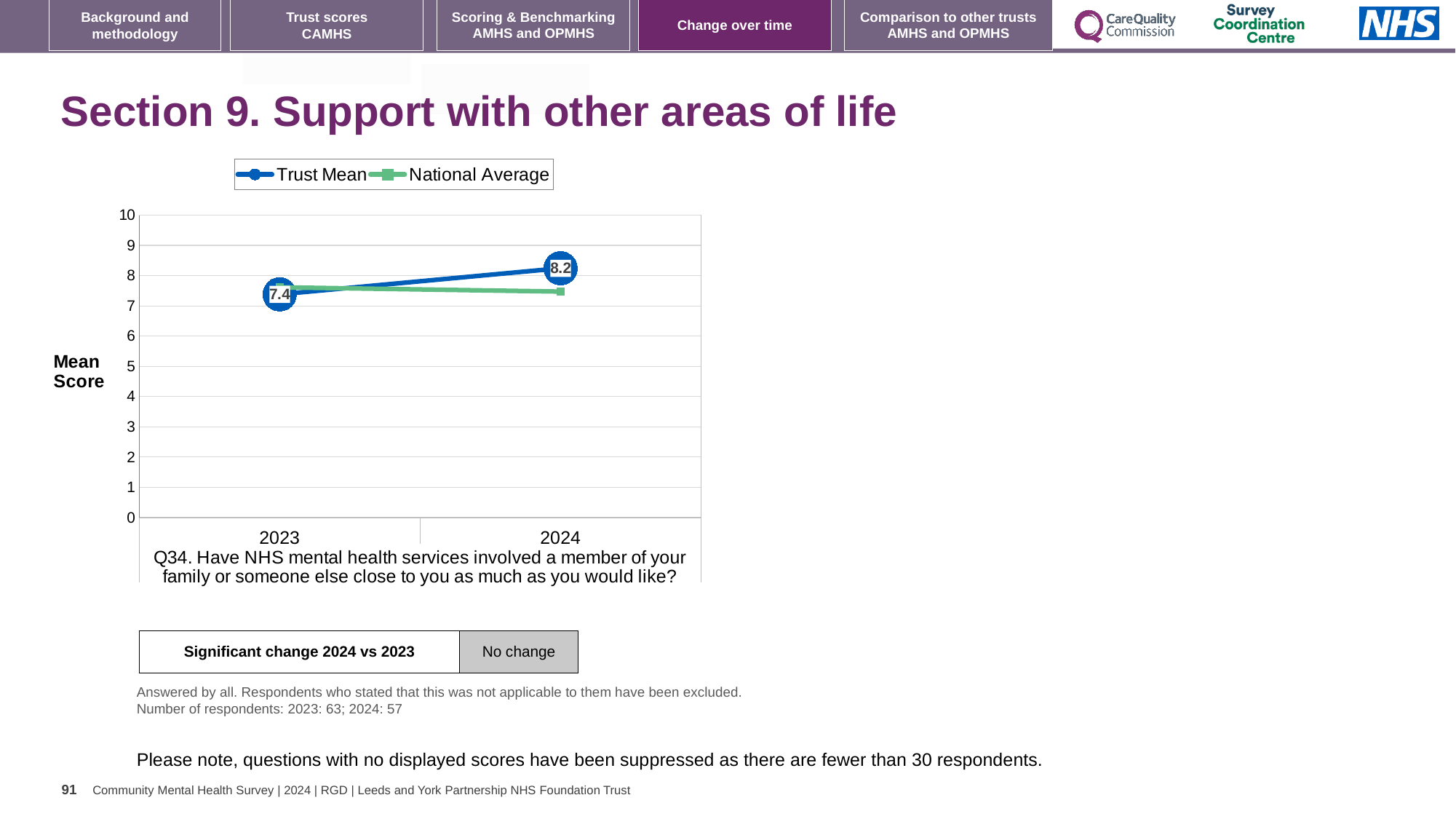
In 2024, which is higher, the Trust Mean or the National Average? Trust Mean What is the Trust Mean score for 2023? 7.4 What is the Trust Mean score for 2024? 8.2 How many years are shown on the x axis? 2 Is the National Average value for 2024 greater or less than 8? less In which year is the Trust Mean score higher, 2023 or 2024? 2024 What is the label of the y axis? Mean Score Does the Trust Mean score rise or fall from 2023 to 2024? rise What kind of chart is shown on the slide? line chart Is the National Average value for 2023 greater or less than 7? greater By how much did the Trust Mean score change from 2023 to 2024? 0.8 How many series does the legend list? 2